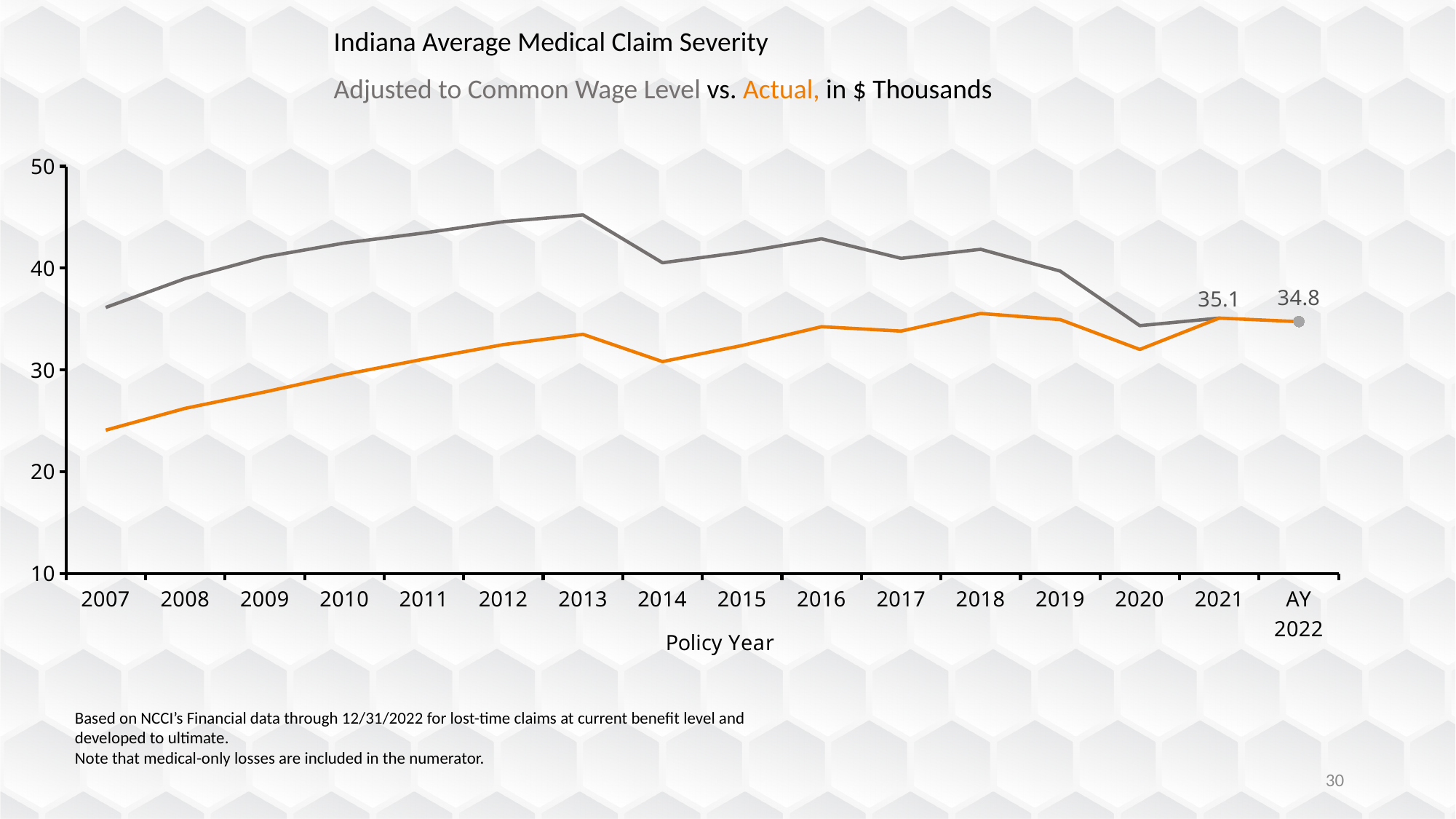
What is the difference between the labeled values for 2021 and AY 2022? 0.3 What value is labeled at AY 2022? 34.8 Is the Actual value for 2007 greater or less than 30? less What value is labeled at policy year 2021? 35.1 How many series are plotted on the chart? 2 In which policy year is the Actual series lowest? 2007 In which policy year is the Adjusted to Common Wage Level series highest? 2013 In 2013, which series is larger, Adjusted to Common Wage Level or Actual? Adjusted to Common Wage Level Is the Adjusted to Common Wage Level value for 2013 greater or less than 40? greater What kind of chart is shown on the slide? line chart How many policy years are shown on the x axis? 16 What is the title of the chart? Indiana Average Medical Claim Severity